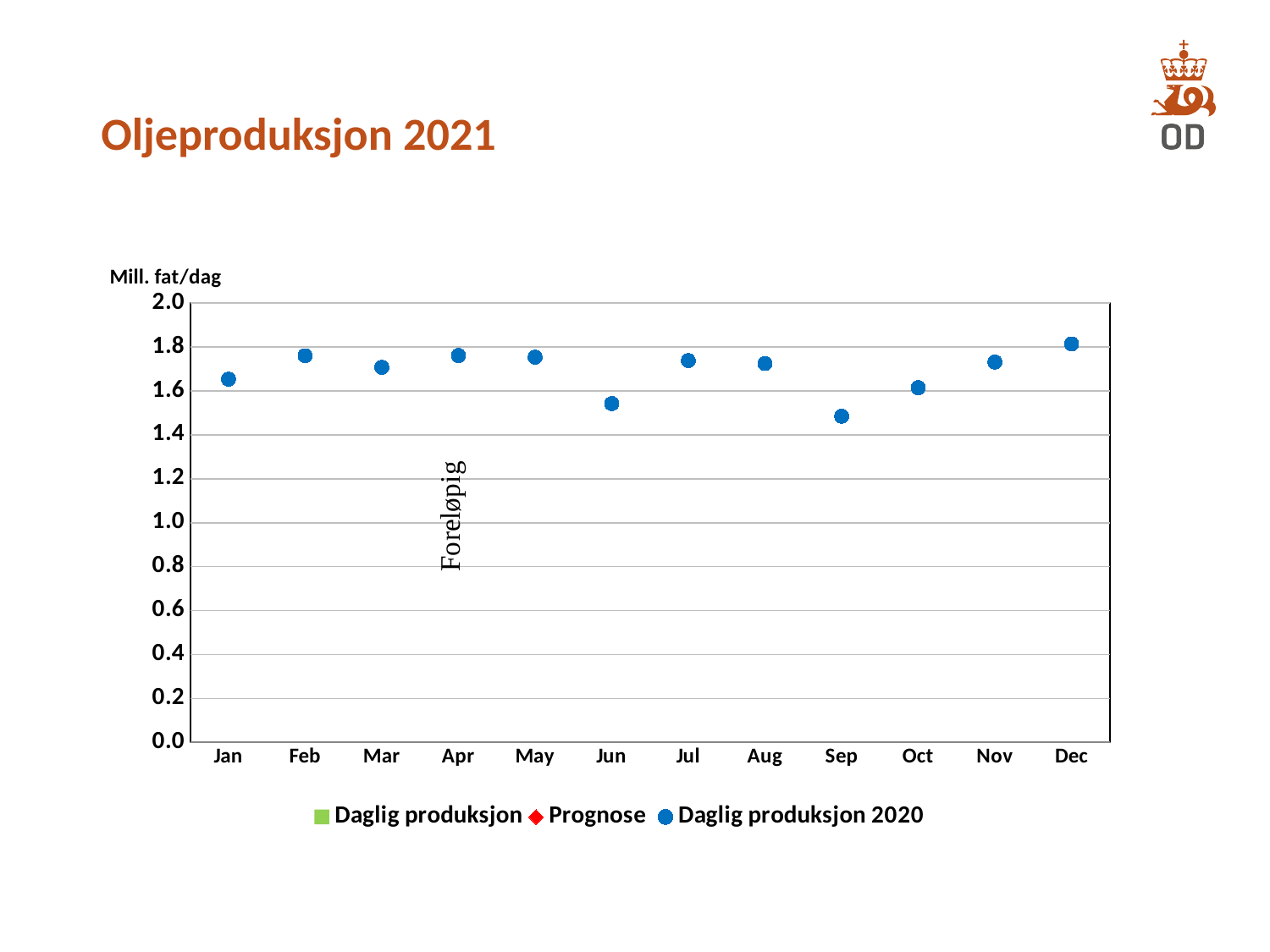
How many months are shown on the x axis? 12 Is the value for Daglig produksjon 2020 in Sep greater or less than 1.6? less What unit is shown on the y axis of the chart? Mill. fat/dag What is the title of the slide? Oljeproduksjon 2021 Which month has the highest value for Daglig produksjon 2020? Dec Which month has the lowest value for Daglig produksjon 2020? Sep Is the value for Daglig produksjon 2020 in Jun greater or less than 1.6? less What type of chart is shown on the slide? Scatter (dot) chart Is the value for Daglig produksjon 2020 in Feb greater or less than 1.6? greater Which is larger for Daglig produksjon 2020: Jun or Sep? Jun Which is larger for Daglig produksjon 2020: Jan or Feb? Feb How many series does the legend list? 3